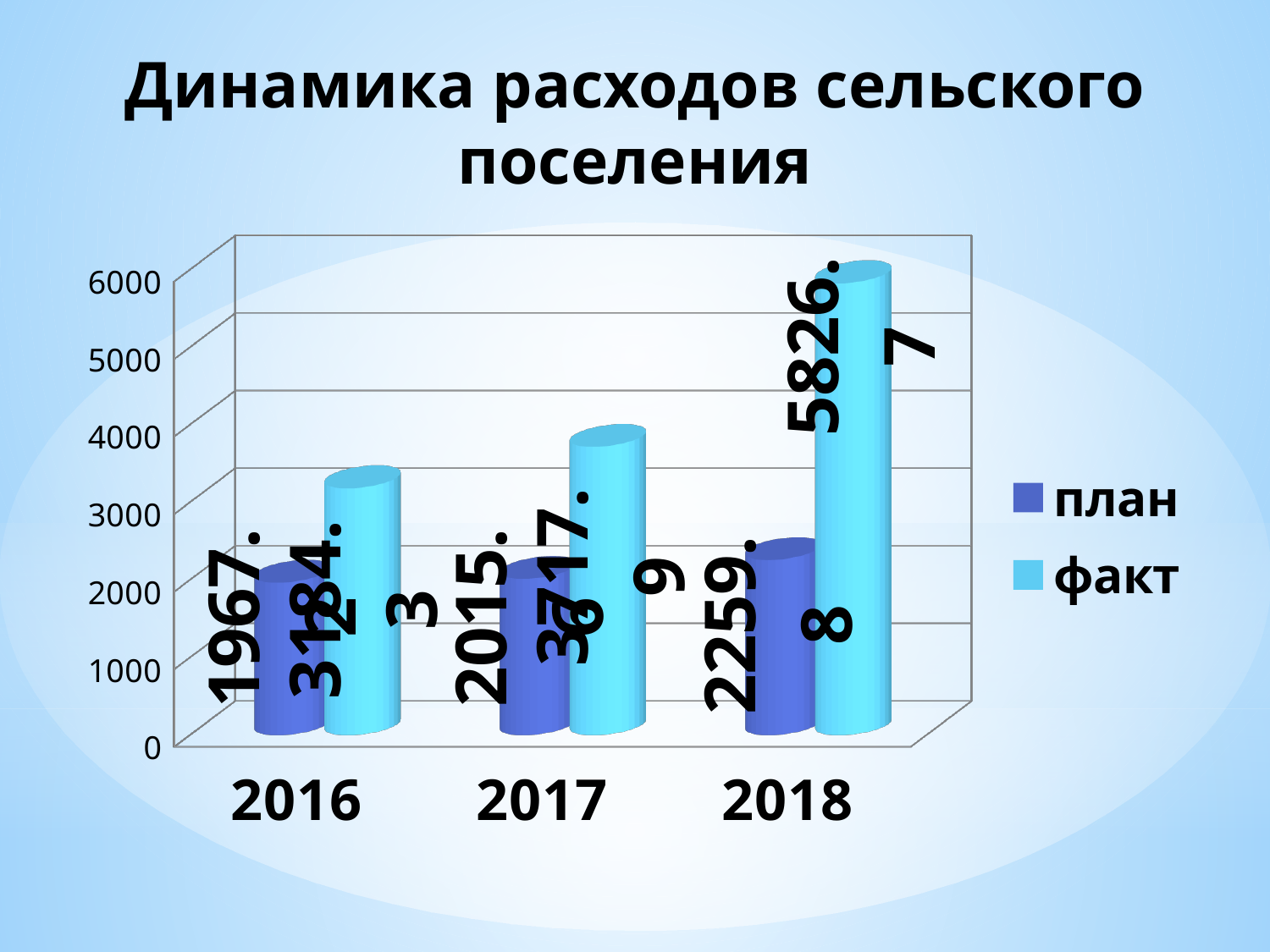
What is the difference between the факт and план values for 2018? 3566.9 What is the value of the факт series for 2016? 3184.3 What is the value of the план series for 2018? 2259.8 What is the value of the факт series for 2018? 5826.7 Is the факт value for 2017 greater or less than 3000? greater What kind of chart is shown on the slide? bar chart What is the value of the план series for 2016? 1967.2 Which year has the highest факт value? 2018 Which is larger for 2017, the план value or the факт value? факт Do the факт values rise or fall from 2016 to 2018? rise How many series does the legend list? 2 Which year has the lowest план value? 2016